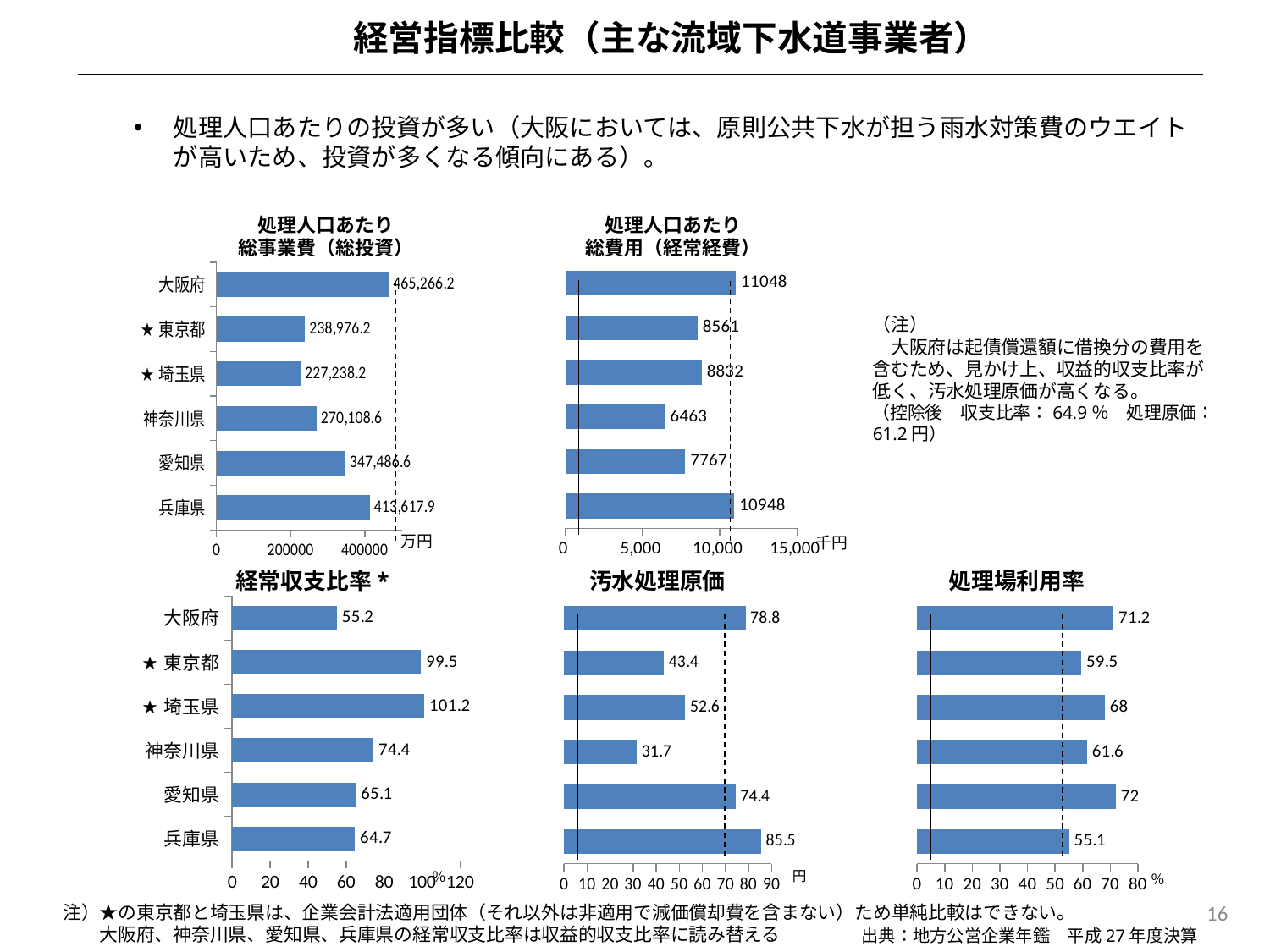
In the 汚水処理原価 chart, which prefecture has the highest value? 兵庫県 How many prefectures are shown in the 処理場利用率 chart? 6 In the 経常収支比率 chart, which is larger, 愛知県 or 神奈川県? 神奈川県 In the 処理人口あたり総事業費（総投資） chart, which prefecture has the lowest value? 埼玉県 In the 処理人口あたり総費用（経常経費） chart, what is the value for 神奈川県? 6463 In the 処理人口あたり総費用（経常経費） chart, which prefecture has the highest value? 大阪府 In the 処理人口あたり総費用（経常経費） chart, what is the difference between 大阪府 and 兵庫県? 100 In the 汚水処理原価 chart, what is the value for 神奈川県? 31.7 In the 処理人口あたり総事業費（総投資） chart, what is the value for 大阪府? 465,266.2 In the 経常収支比率 chart, what is the value for 埼玉県? 101.2 In the 処理場利用率 chart, which prefecture has the lowest value? 兵庫県 In the 処理場利用率 chart, what is the value for 愛知県? 72